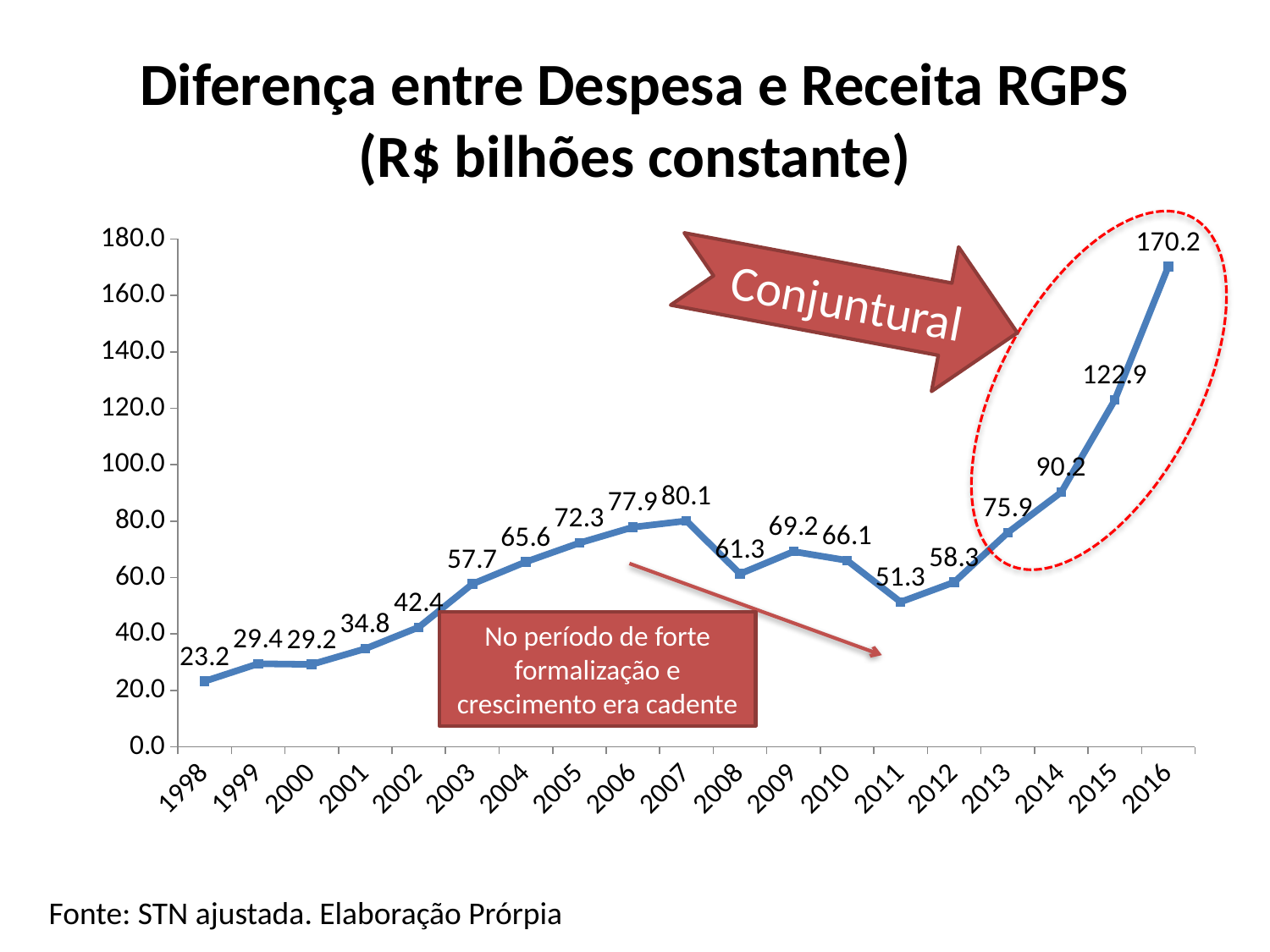
What is the value for 2007? 80.1 What is the difference between the values for 2016 and 2015? 47.3 How many years are plotted on the chart? 19 What is the value for 2011? 51.3 Which is larger, the value for 2009 or the value for 2010? 2009 Which year has the highest value? 2016 Do the values rise or fall from 2011 to 2016? rise Which year has the lowest value? 1998 What is the difference between the values for 2007 and 2008? 18.8 Is the value for 2014 greater or less than 100.0? less What is the value for 2016? 170.2 What kind of chart is shown on the slide? line chart